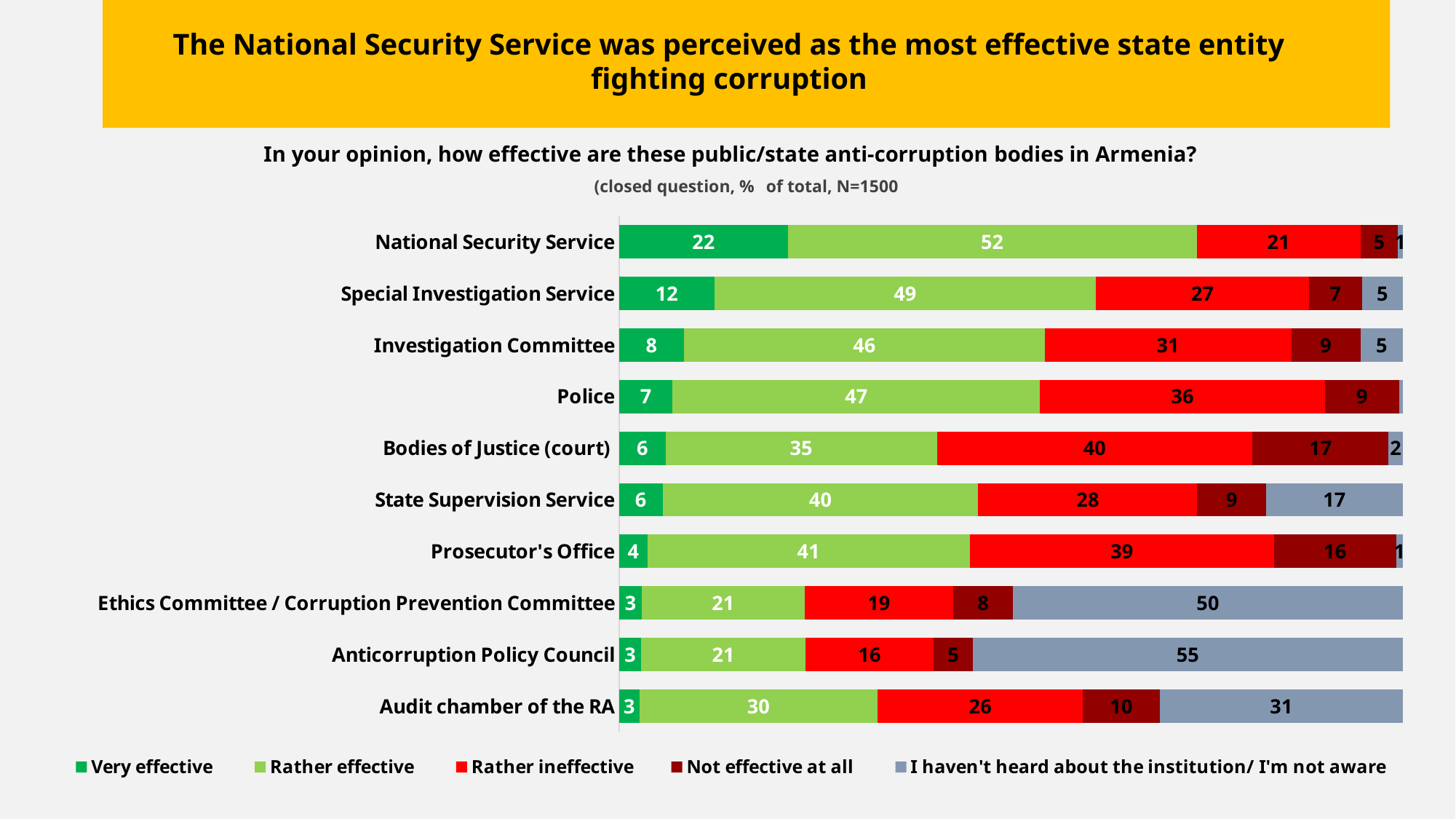
What percentage of respondents rated the National Security Service as "Very effective"? 22 What kind of chart is shown on the slide? Stacked bar chart What is the total of the stacked bar for the Anticorruption Policy Council? 100 How many institutions are shown in the chart? 10 What is the "Rather ineffective" value for the Police? 36 Which institution has the highest "I haven't heard about the institution/ I'm not aware" value? Anticorruption Policy Council Which institution has the highest "Very effective" value? National Security Service What is the difference between the "Very effective" values for the National Security Service and the Special Investigation Service? 10 What is the "Not effective at all" value for the Audit chamber of the RA? 10 How many series does the legend list? 5 What is the "I haven't heard about the institution/ I'm not aware" value for the Ethics Committee / Corruption Prevention Committee? 50 Which has a larger "Rather effective" value, the Special Investigation Service or the Bodies of Justice (court)? Special Investigation Service